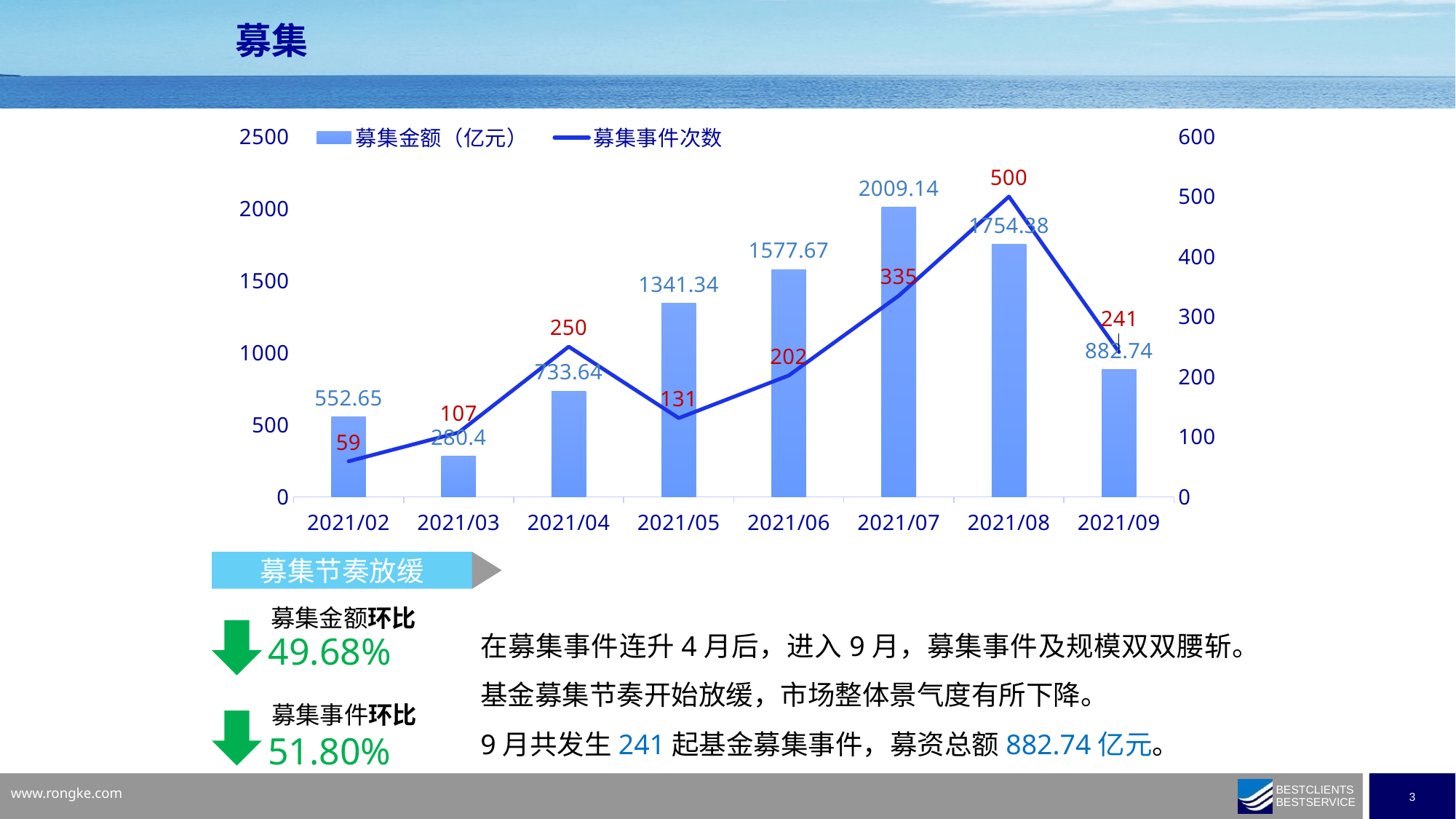
Which month has the lowest 募集事件次数? 2021/02 Does the 募集事件次数 line rise or fall from 2021/08 to 2021/09? fall How many series does the chart legend list? 2 What is the 募集金额（亿元） value for 2021/09? 882.74 What is the 募集事件次数 value for 2021/05? 131 How many months are shown on the x axis of the chart? 8 Which is larger, the 募集金额（亿元） for 2021/05 or for 2021/06? 2021/06 Which month has the highest 募集金额（亿元）? 2021/07 What is the difference in 募集事件次数 between 2021/08 and 2021/09? 259 What is the 募集事件次数 value for 2021/08? 500 Which month has the lowest 募集金额（亿元）? 2021/03 What is the 募集金额（亿元） value for 2021/07? 2009.14